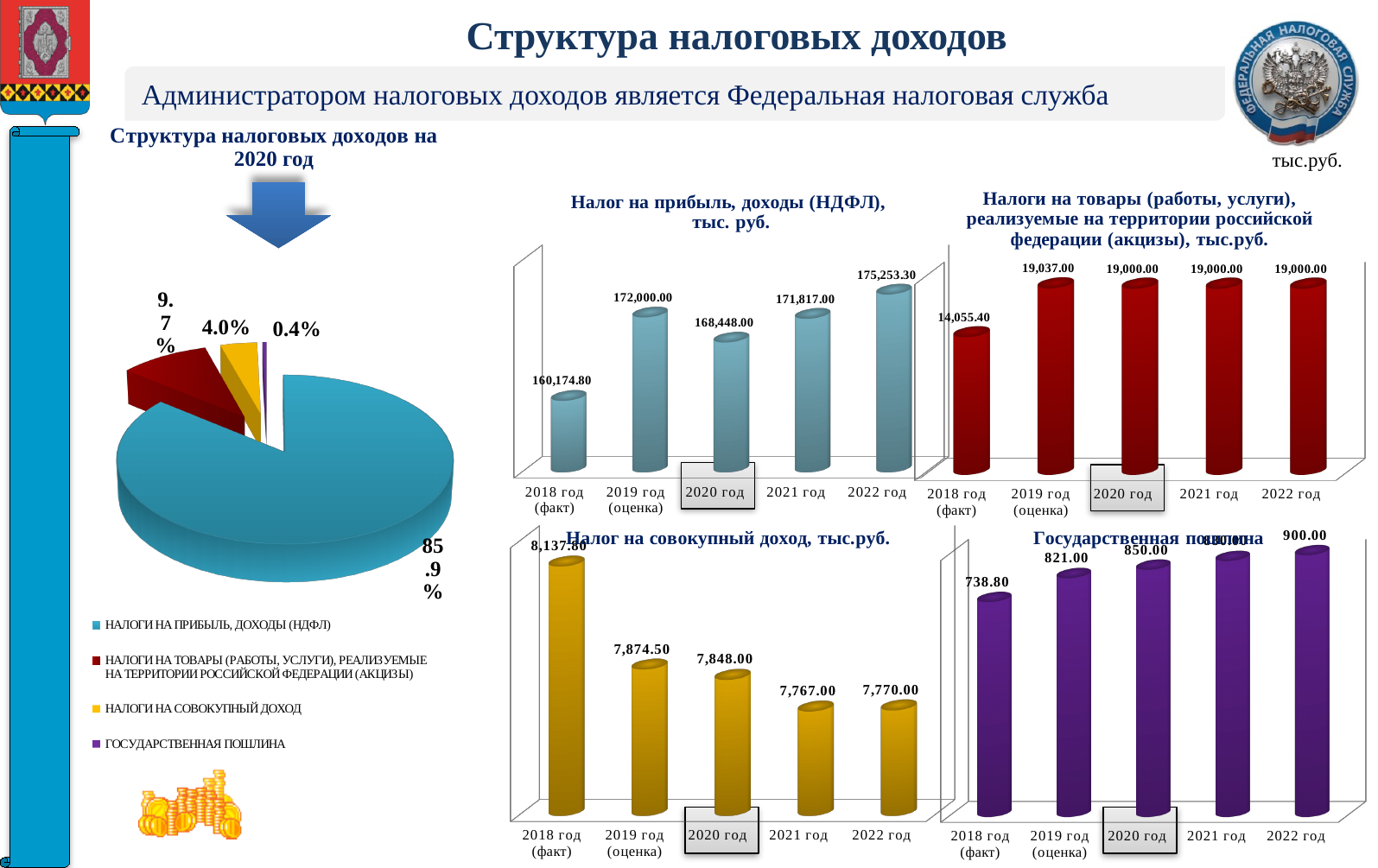
In the chart 'Налог на прибыль, доходы (НДФЛ), тыс. руб.', which year has the highest value? 2022 год In the pie chart 'Структура налоговых доходов на 2020 год', which category has the smallest share? ГОСУДАРСТВЕННАЯ ПОШЛИНА What kind of chart is 'Государственная пошлина'? bar chart In the pie chart 'Структура налоговых доходов на 2020 год', what share does 'НАЛОГИ НА ПРИБЫЛЬ, ДОХОДЫ (НДФЛ)' have? 85.9% In the chart 'Налог на прибыль, доходы (НДФЛ), тыс. руб.', what is the value for 2020 год? 168,448.00 In the chart 'Налог на совокупный доход, тыс.руб.', what is the value for 2021 год? 7,767.00 In the chart 'Государственная пошлина', what is the value for 2019 год (оценка)? 821.00 In the chart 'Налоги на товары (работы, услуги), реализуемые на территории российской федерации (акцизы), тыс.руб.', what is the value for 2018 год (факт)? 14,055.40 In the chart 'Налог на прибыль, доходы (НДФЛ), тыс. руб.', what is the difference between 2019 год (оценка) and 2018 год (факт)? 11,825.20 In the chart 'Налог на совокупный доход, тыс.руб.', which is larger: the value for 2018 год (факт) or 2022 год? 2018 год (факт) How many categories does the legend of the pie chart 'Структура налоговых доходов на 2020 год' list? 4 In the chart 'Налоги на товары (работы, услуги), реализуемые на территории российской федерации (акцизы), тыс.руб.', which year has the highest value? 2019 год (оценка)